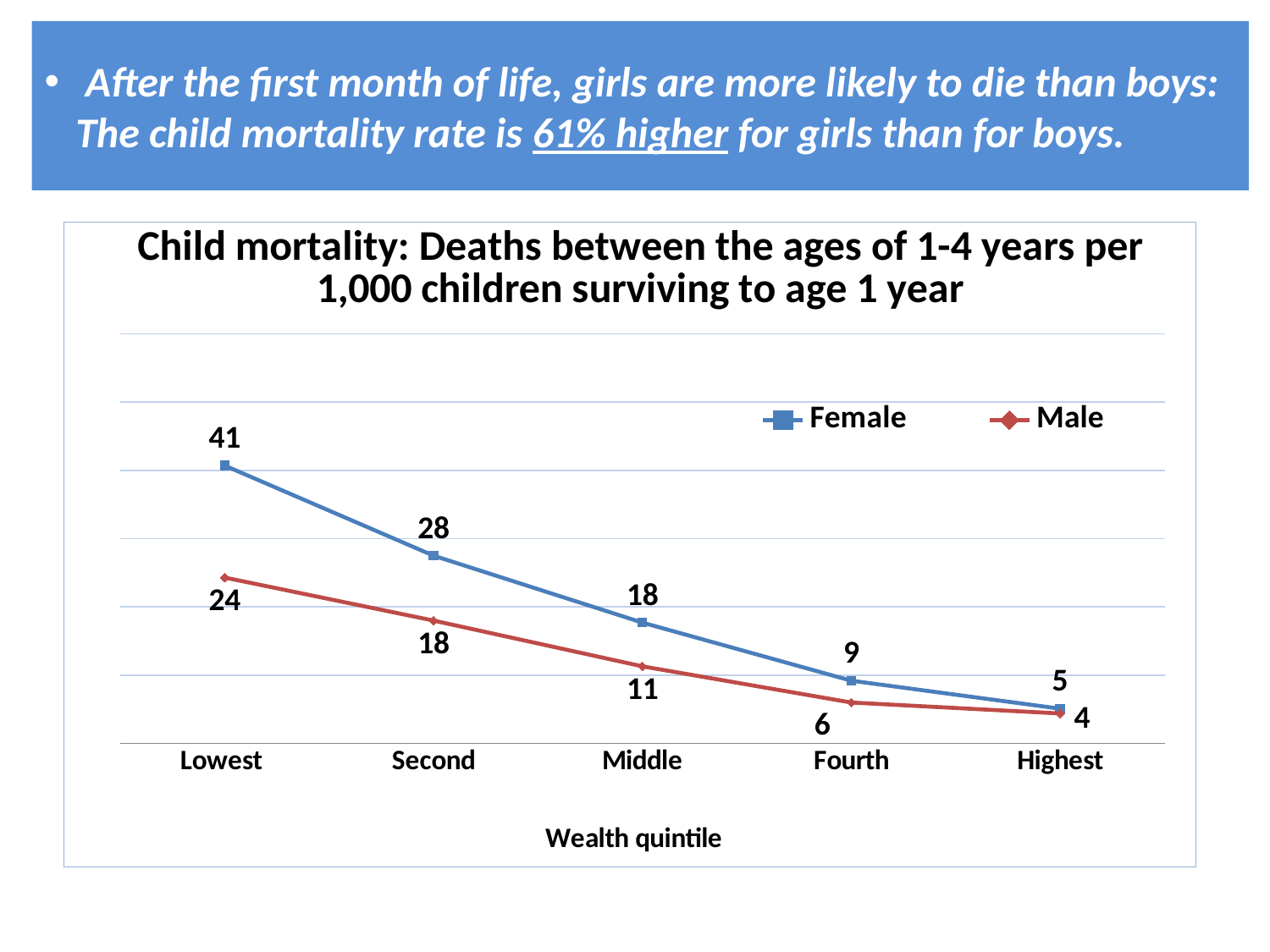
What is the Female child mortality value for the Lowest wealth quintile? 41 Which is larger for the Fourth wealth quintile, the Female value or the Male value? Female How many series does the legend list? 2 What kind of chart is shown on the slide? Line chart Do the Female values rise or fall from the Lowest to the Highest wealth quintile? Fall What is the Male child mortality value for the Second wealth quintile? 18 How many wealth quintile categories are shown on the x axis? 5 Which wealth quintile has the lowest Male child mortality value? Highest What is the Female value for the Highest wealth quintile? 5 What is the difference between the Female and Male values for the Middle wealth quintile? 7 What is the difference between the Female and Male values for the Lowest wealth quintile? 17 Which wealth quintile has the highest Female child mortality value? Lowest